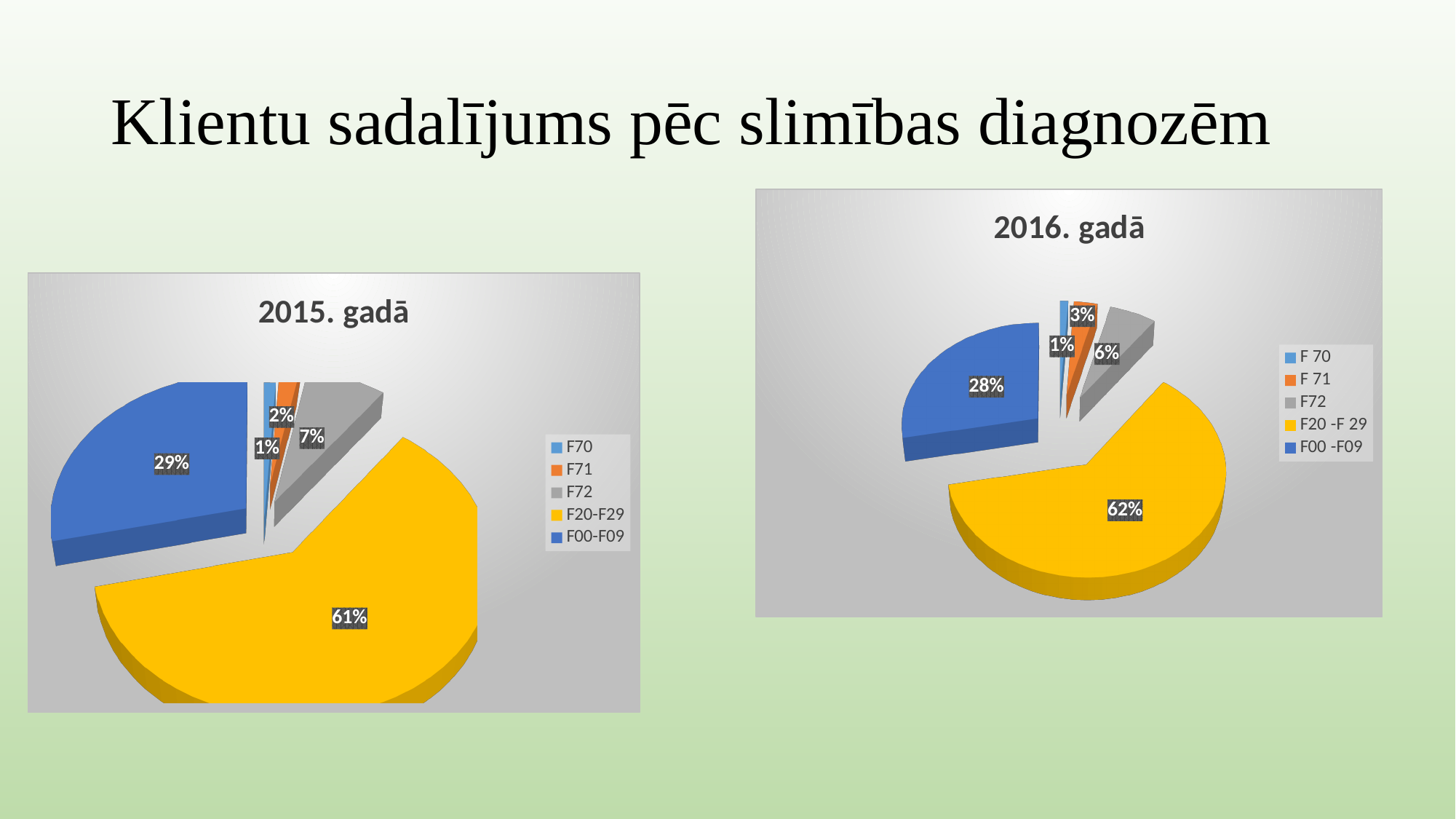
In the "2015. gadā" chart, which category has the largest slice? F20-F29 In the "2016. gadā" chart, what share does F 71 have? 3% In the "2015. gadā" chart, what is the difference between the F20-F29 share and the F00-F09 share? 32% In the "2016. gadā" chart, which category has the smallest slice? F 70 What type of chart is the "2015. gadā" chart? Pie chart In the "2016. gadā" chart, what share does F00 -F09 have? 28% In the "2016. gadā" chart, what is the difference between the F72 share and the F 71 share? 3% How many slices does the "2016. gadā" chart have? 5 In the "2015. gadā" chart, what share does F72 have? 7% In the "2015. gadā" chart, what share does F20-F29 have? 61% Which is larger: the F72 share in the "2015. gadā" chart or the F72 share in the "2016. gadā" chart? 2015. gadā What colour is the F20-F29 slice in the "2015. gadā" chart? Yellow